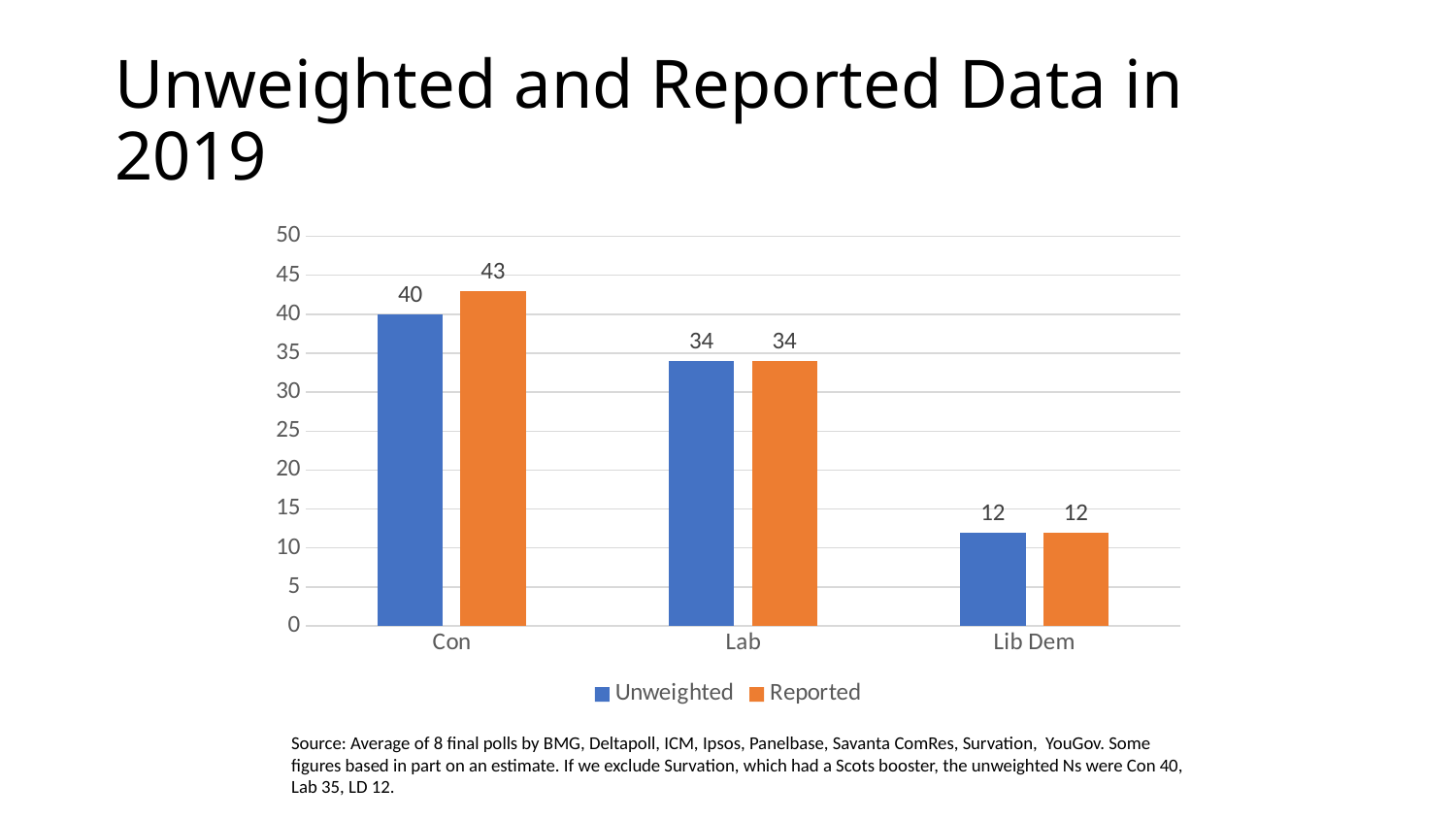
What is the Unweighted value for Lib Dem? 12 Which category has the lowest Unweighted value? Lib Dem What is the Reported value for Lab? 34 What is the difference between the Reported and Unweighted values for Con? 3 What is the Unweighted value for Con? 40 How many series does the legend list? 2 Which category has the highest Reported value? Con What is the Reported value for Con? 43 How many categories are shown on the x axis? 3 Which series is shown in orange? Reported What kind of chart is shown on the slide? Bar chart Which is larger for Con, the Unweighted value or the Reported value? Reported